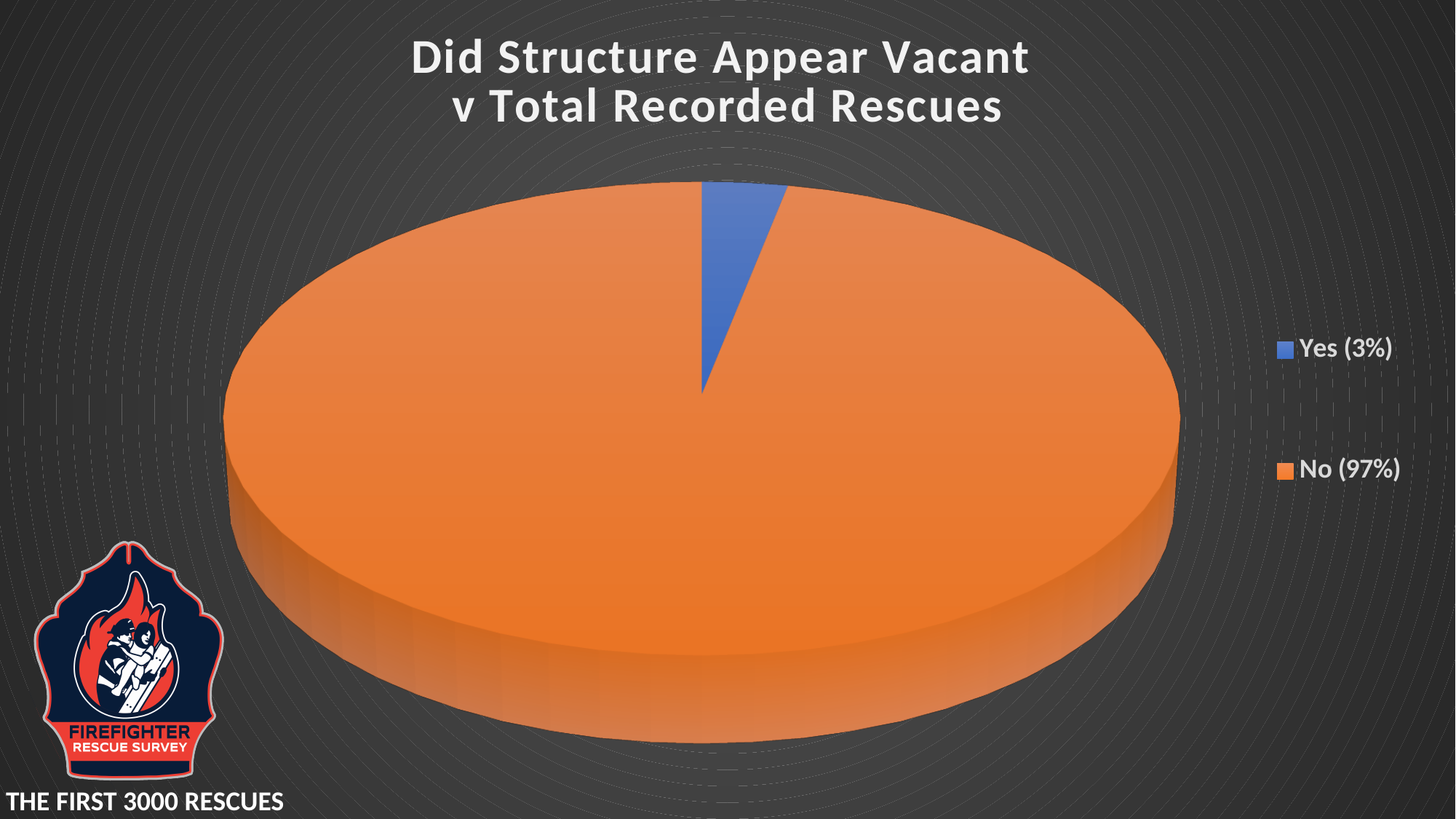
What is the title of the chart? Did Structure Appear Vacant v Total Recorded Rescues Which category has the smallest slice of the pie? Yes How many categories does the pie chart show? 2 What type of chart is shown on the slide? Pie chart What colour is the "Yes" slice? Blue Which category has the largest slice of the pie? No What is the difference in percentage points between the "No" and "Yes" slices? 94 What share of the pie does the "Yes" slice represent? 3% Is the share for "No" greater or less than 50%? greater Which slice is larger, "Yes" or "No"? No What share of the pie does the "No" slice represent? 97% How many entries does the legend list? 2